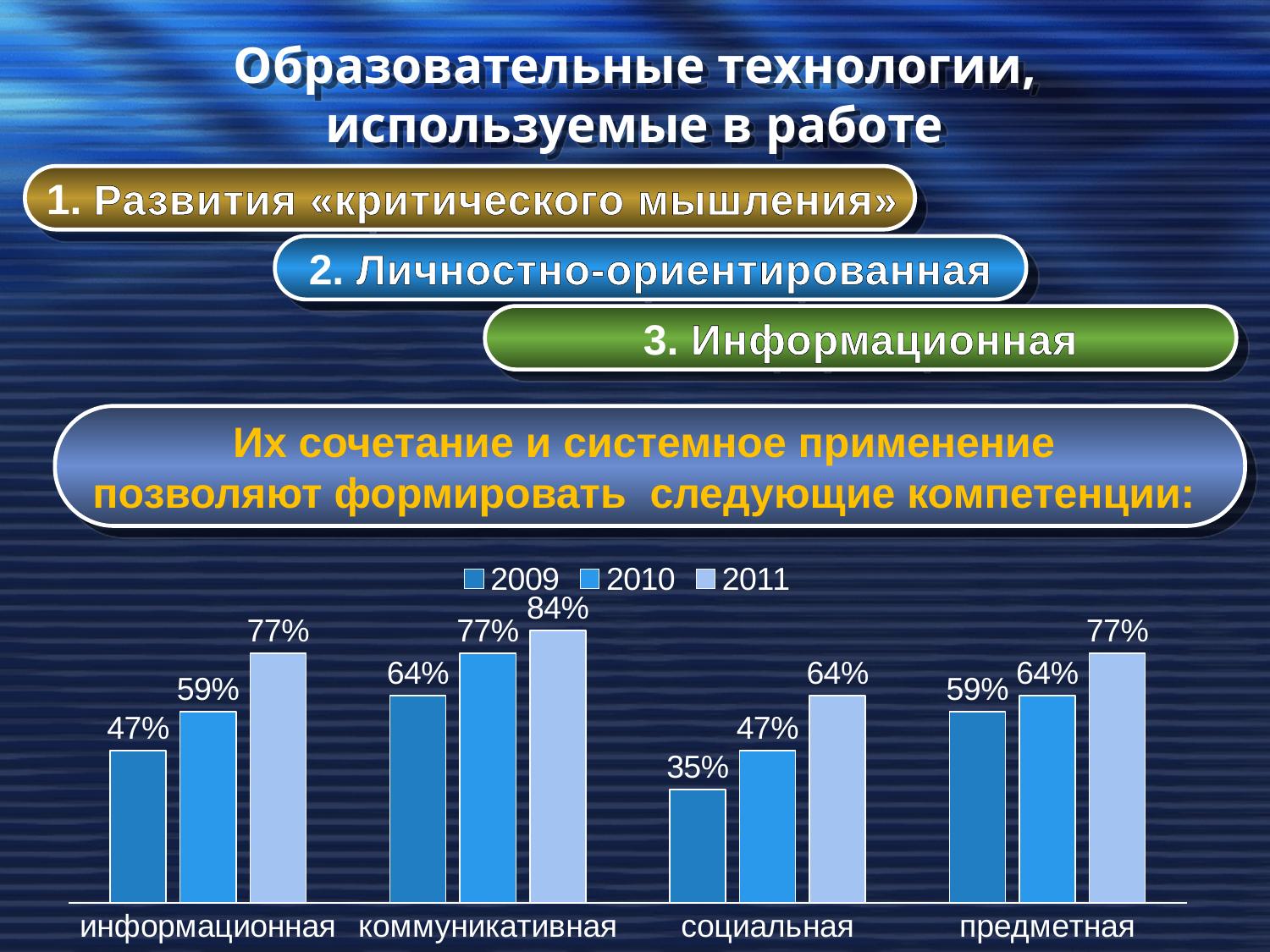
Which category has the highest value in 2011? коммуникативная Which is larger: the 2010 value for коммуникативная or the 2010 value for социальная? коммуникативная Which years are listed in the chart legend? 2009, 2010, 2011 What is the value for предметная in 2010? 64% For социальная, do the values rise or fall from 2009 to 2011? rise How many categories are shown on the x axis of the chart? 4 What kind of chart is shown on the slide? bar chart Which category has the lowest value in 2009? социальная What is the value for социальная in 2009? 35% What is the value for коммуникативная in 2011? 84% How many series does the chart legend list? 3 What is the difference between the 2011 and 2009 values for информационная? 30%